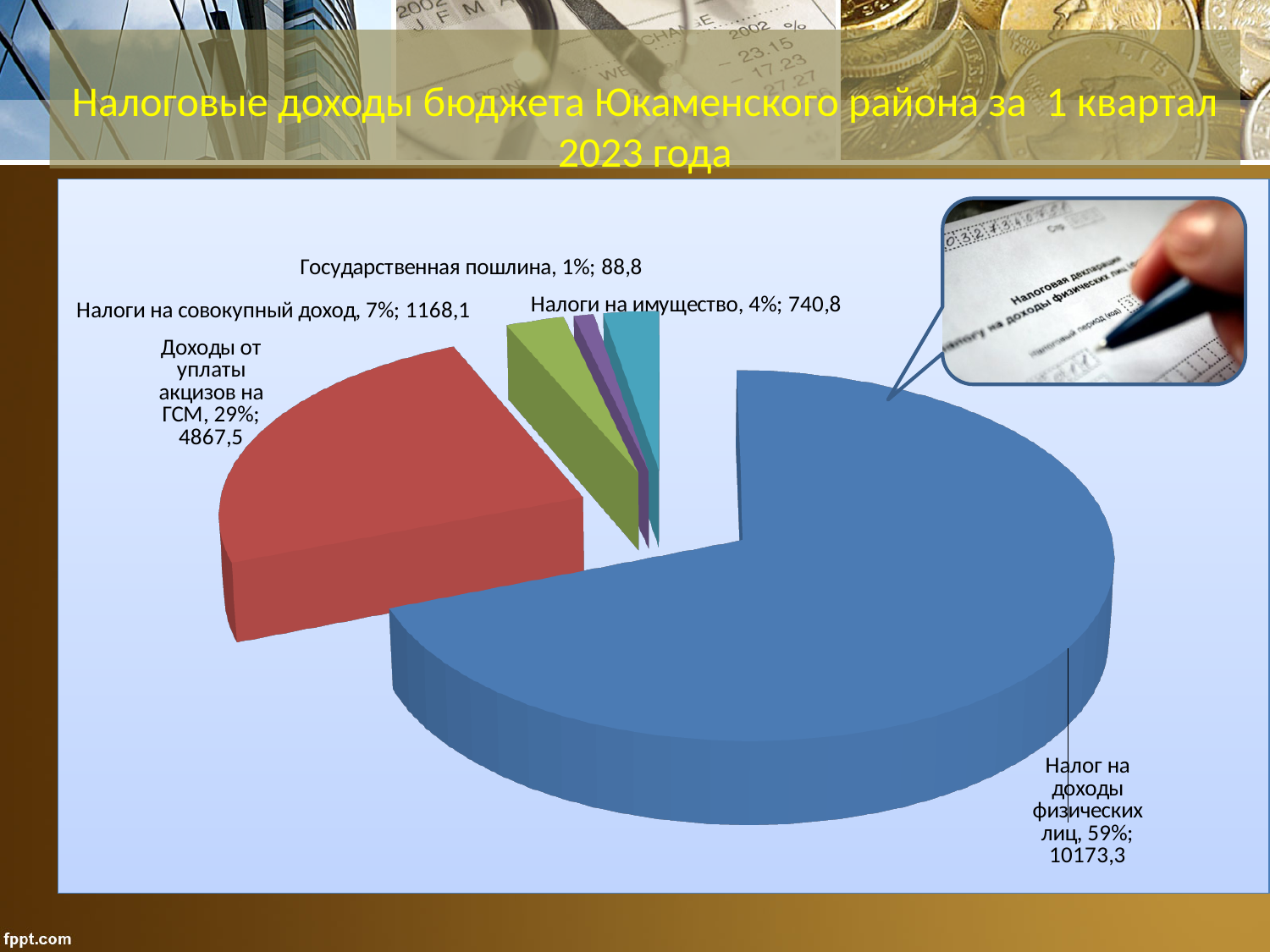
How many categories are shown in the pie chart? 5 What kind of chart is shown on the slide? Pie chart What value is shown for Налоги на совокупный доход? 1168,1 What value is shown for Доходы от уплаты акцизов на ГСМ? 4867,5 What value is shown for Налоги на имущество? 740,8 What value is shown for Налог на доходы физических лиц? 10173,3 Which category has the smallest slice of the pie? Государственная пошлина What value is shown for Государственная пошлина? 88,8 What share of the pie does Доходы от уплаты акцизов на ГСМ represent? 29% Which category has the largest slice of the pie? Налог на доходы физических лиц What share of the pie does Налог на доходы физических лиц represent? 59% Which is larger, Налоги на совокупный доход or Налоги на имущество? Налоги на совокупный доход